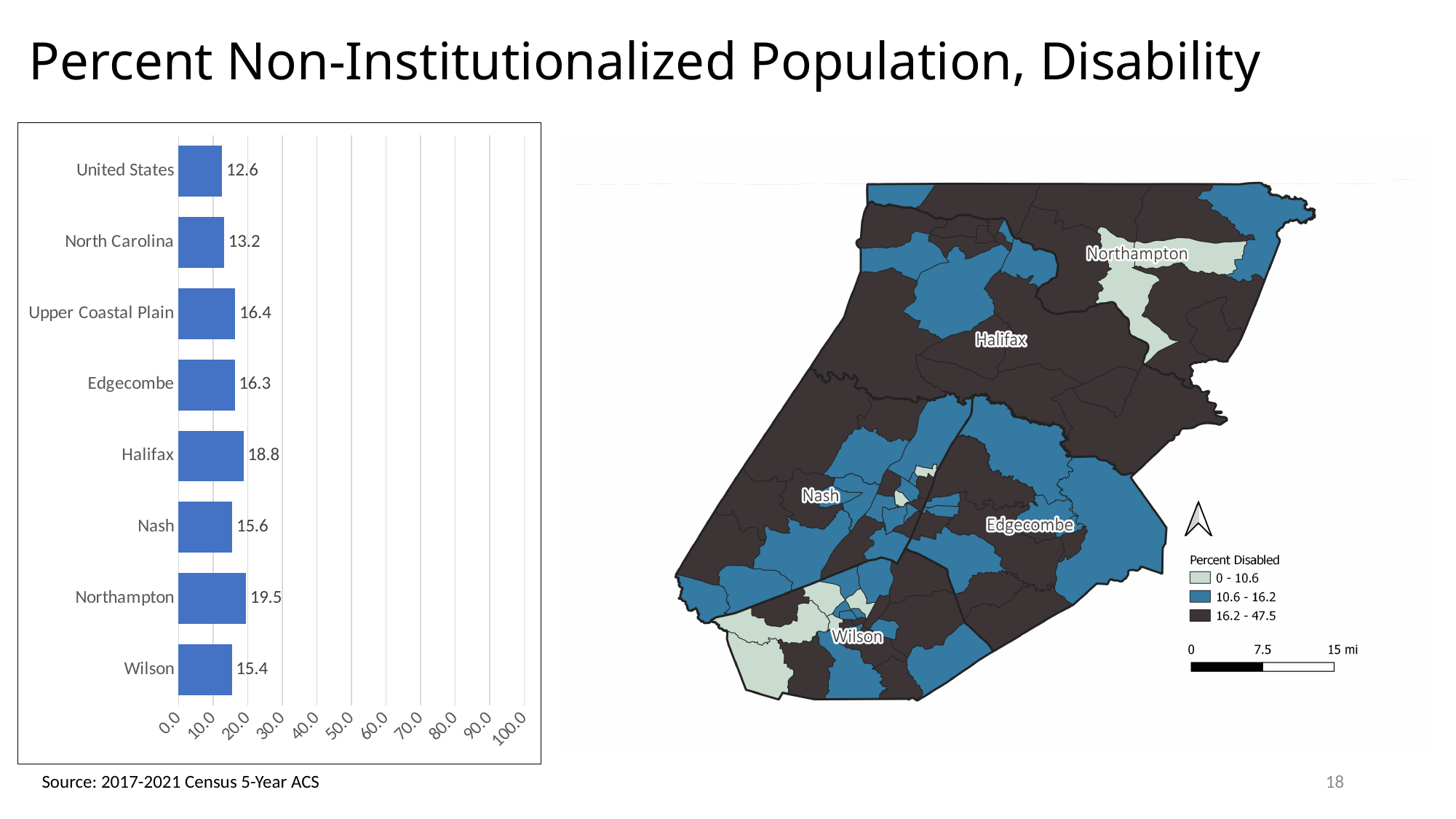
What is the difference between the values for Edgecombe and Wilson in the bar chart? 0.9 What is the value for Wilson in the bar chart? 15.4 Which category has the lowest value in the bar chart? United States Which category has the highest value in the bar chart? Northampton Is the value for Upper Coastal Plain in the bar chart greater or less than 20.0? less How many categories are shown in the bar chart? 8 What is the value for Halifax in the bar chart? 18.8 Which has a larger value in the bar chart, Halifax or Nash? Halifax What is the highest value shown on the x axis of the bar chart? 100.0 What is the difference between the values for Northampton and North Carolina in the bar chart? 6.3 What is the value for the United States in the bar chart? 12.6 What kind of chart is shown on the left of the slide? bar chart